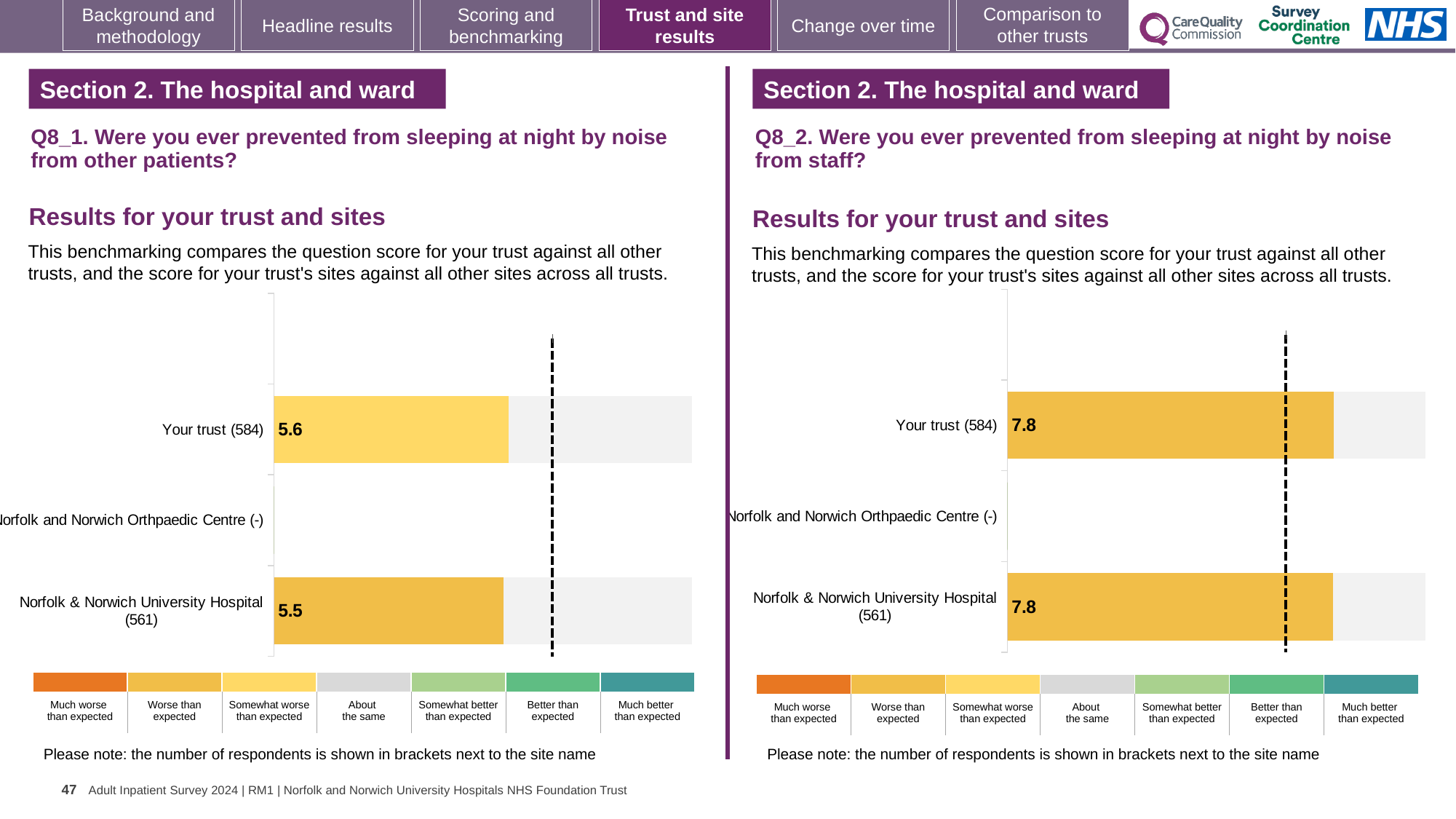
On the Q8_2 chart (right), what is the score for Your trust (584)? 7.8 On the Q8_2 chart (right), what is the difference between the score for Your trust (584) and the score for Norfolk & Norwich University Hospital (561)? 0 What kind of chart is used on the Q8_1 chart (left)? Bar chart On the Q8_1 chart (left), which benchmark band does the Your trust (584) bar fall into according to the colour key? Somewhat worse than expected How many categories are listed on the vertical axis of the Q8_2 chart (right)? 3 On the Q8_1 chart (left), what is the difference between the score for Your trust (584) and the score for Norfolk & Norwich University Hospital (561)? 0.1 How many respondents are shown in brackets for Norfolk & Norwich University Hospital on the Q8_2 chart (right)? 561 On the Q8_1 chart (left), which category has no bar plotted? Norfolk and Norwich Orthpaedic Centre (-) Is the score for Your trust (584) on the Q8_2 chart (right) larger than the score for Your trust (584) on the Q8_1 chart (left)? Yes On the Q8_1 chart (left), what is the score for Norfolk & Norwich University Hospital (561)? 5.5 On the Q8_2 chart (right), what is the score for Norfolk & Norwich University Hospital (561)? 7.8 On the Q8_1 chart (left), what is the score for Your trust (584)? 5.6